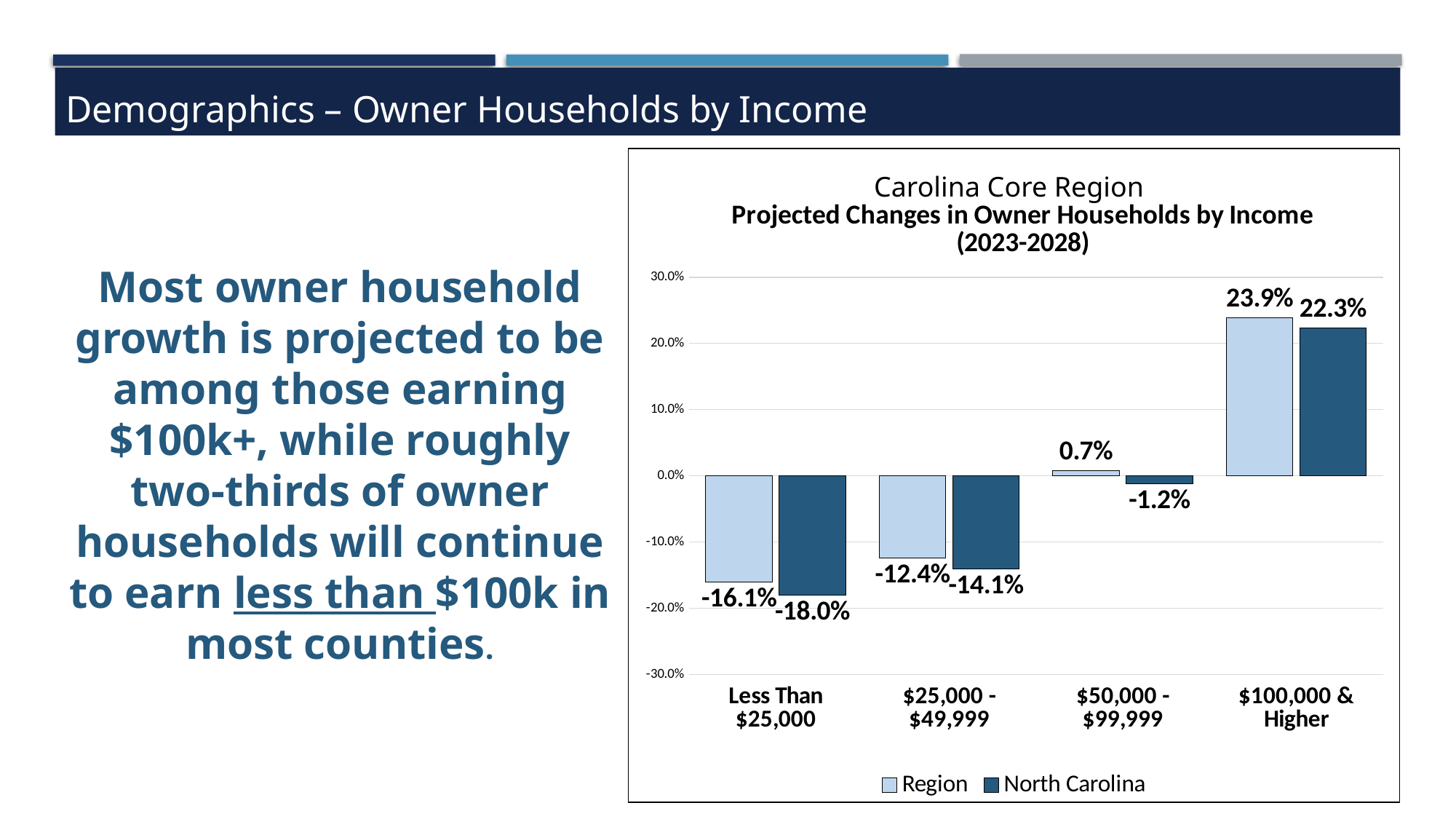
In the $25,000 - $49,999 category, which is larger, the Region value or the North Carolina value? Region Which series is shown in the darker blue colour? North Carolina What kind of chart is shown on the slide? Bar chart Which income category has the highest projected change for the Region? $100,000 & Higher What is the difference between the Region and North Carolina values in the $100,000 & Higher category? 1.6% What is the projected change for North Carolina in the $100,000 & Higher income category? 22.3% What is the projected change for the Region in the Less Than $25,000 income category? -16.1% Which income category has the lowest projected change for North Carolina? Less Than $25,000 How many income categories are shown on the x axis? 4 What is the projected change for the Region in the $25,000 - $49,999 income category? -12.4% What is the projected change for North Carolina in the $50,000 - $99,999 income category? -1.2% How many series does the legend list? 2